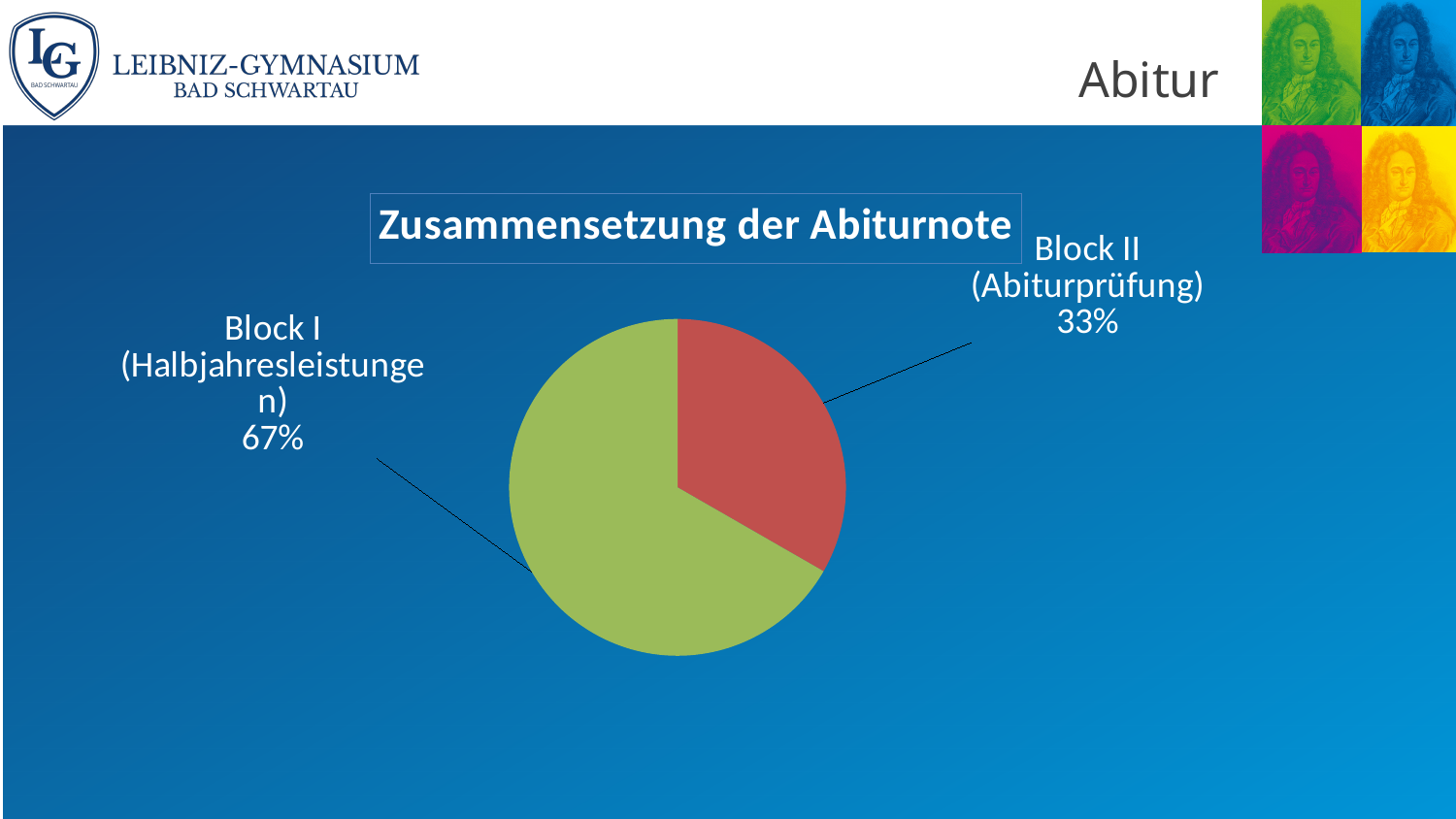
What colour is the Block II (Abiturprüfung) slice? Red Which slice is the largest in the pie chart? Block I (Halbjahresleistungen) Which is larger, the share for Block I or the share for Block II? Block I How many slices does the pie chart have? 2 Which slice is the smallest in the pie chart? Block II (Abiturprüfung) What share of the pie does Block I (Halbjahresleistungen) represent? 67% What is the title of the chart? Zusammensetzung der Abiturnote What is the difference in percentage points between Block I and Block II? 34 What share of the pie does Block II (Abiturprüfung) represent? 33% What type of chart is shown on the slide? Pie chart